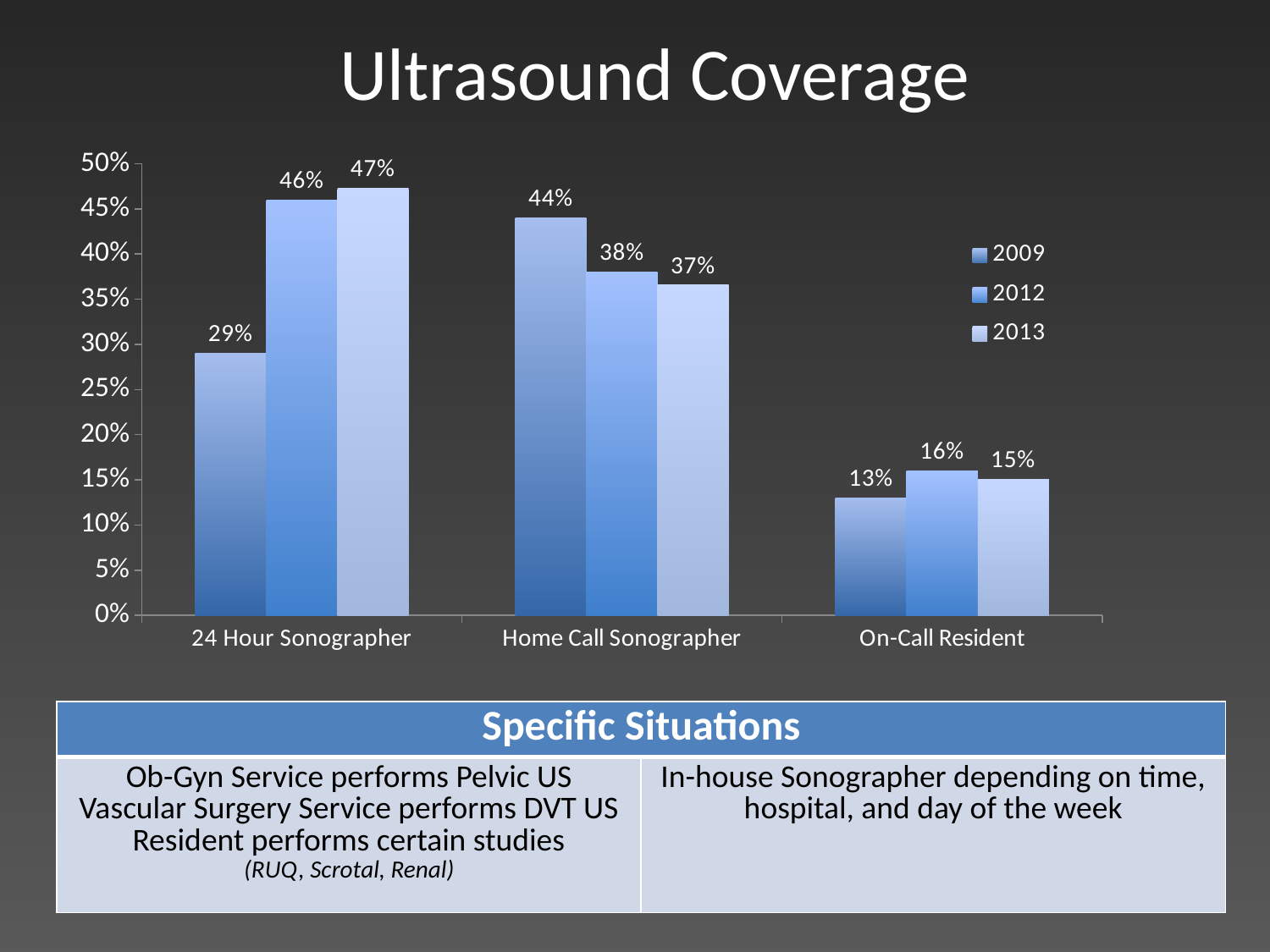
What is the value for On-Call Resident in 2012? 16% How many series does the legend list? 3 What is the title of the chart? Ultrasound Coverage What kind of chart is shown on the slide? Bar chart How many categories are shown on the x axis? 3 Which is larger for Home Call Sonographer: the 2009 value or the 2012 value? 2009 What is the value for 24 Hour Sonographer in 2009? 29% Which category has the lowest value in 2009? On-Call Resident What is the value for Home Call Sonographer in 2013? 37% What is the difference between the 2013 and 2009 values for 24 Hour Sonographer? 18% Which category has the highest value in 2013? 24 Hour Sonographer Do the values for Home Call Sonographer rise or fall from 2009 to 2013? Fall